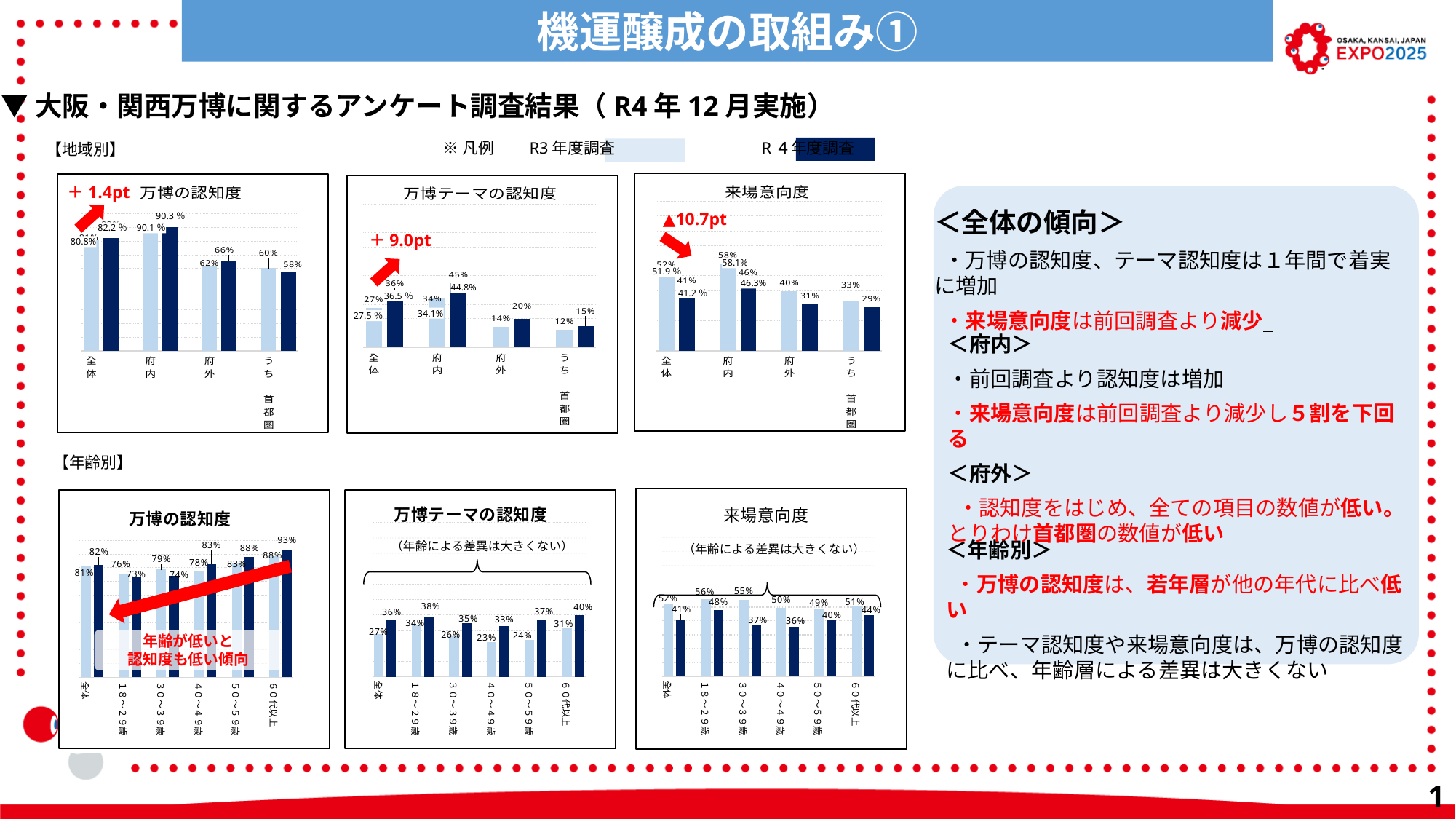
How many categories are shown on the x axis of the bottom-row chart titled 来場意向度 (年齢別)? 6 In the top-row chart titled 万博の認知度 (地域別), what is the R4年度調査 value for 府内? 90.3% In the bottom-row chart titled 万博テーマの認知度 (年齢別), what is the R3年度調査 value for 40～49歳? 23% In the bottom-row chart titled 万博の認知度 (年齢別), what is the R4年度調査 value for 18～29歳? 73% What type of chart is the top-row chart titled 万博の認知度 (地域別)? bar chart In the top-row chart titled 来場意向度 (地域別), which region has the lowest R4年度調査 value? うち首都圏 In the bottom-row chart titled 来場意向度 (年齢別), is the R3年度調査 value for 30～39歳 larger or smaller than the R4年度調査 value? larger In the top-row chart titled 万博テーマの認知度 (地域別), what is the R4年度調査 value for うち首都圏? 15% In the top-row chart titled 万博テーマの認知度 (地域別), what is the difference between the R4年度調査 and R3年度調査 values for 府外? 6% In the bottom-row chart titled 万博の認知度 (年齢別), which age group has the highest R4年度調査 value? 60代以上 How many survey series does the legend (凡例) list for the charts? 2 In the top-row chart titled 来場意向度 (地域別), what is the R3年度調査 value for 全体? 51.9%